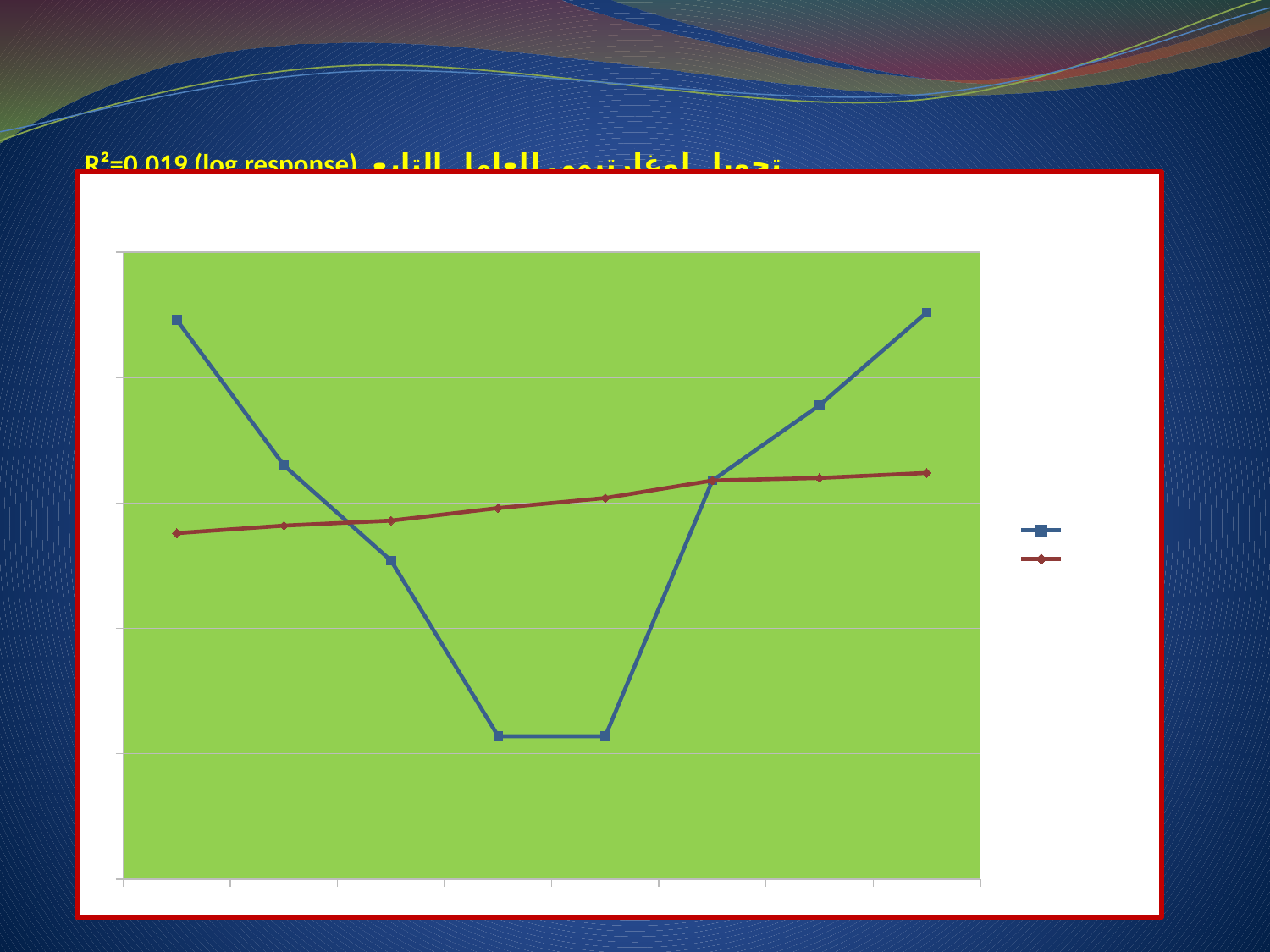
How many data points does the red line have? 8 What kind of chart is shown on the slide? line chart Does the blue line rise or fall between its fifth and last points? rise What marker shape is used on the red line? diamond Which line has the lowest point on the chart, the blue line or the red line? blue line What colour is the plot area background of the chart? green Does the red line rise or fall from left to right along the x axis? rise How many data points does the blue line have? 8 At the leftmost point, which line is higher, the blue line or the red line? blue line At the fourth point from the left, which line is higher, the blue line or the red line? red line Does the blue line rise or fall between its first and fourth points? fall How many series does the legend list? 2